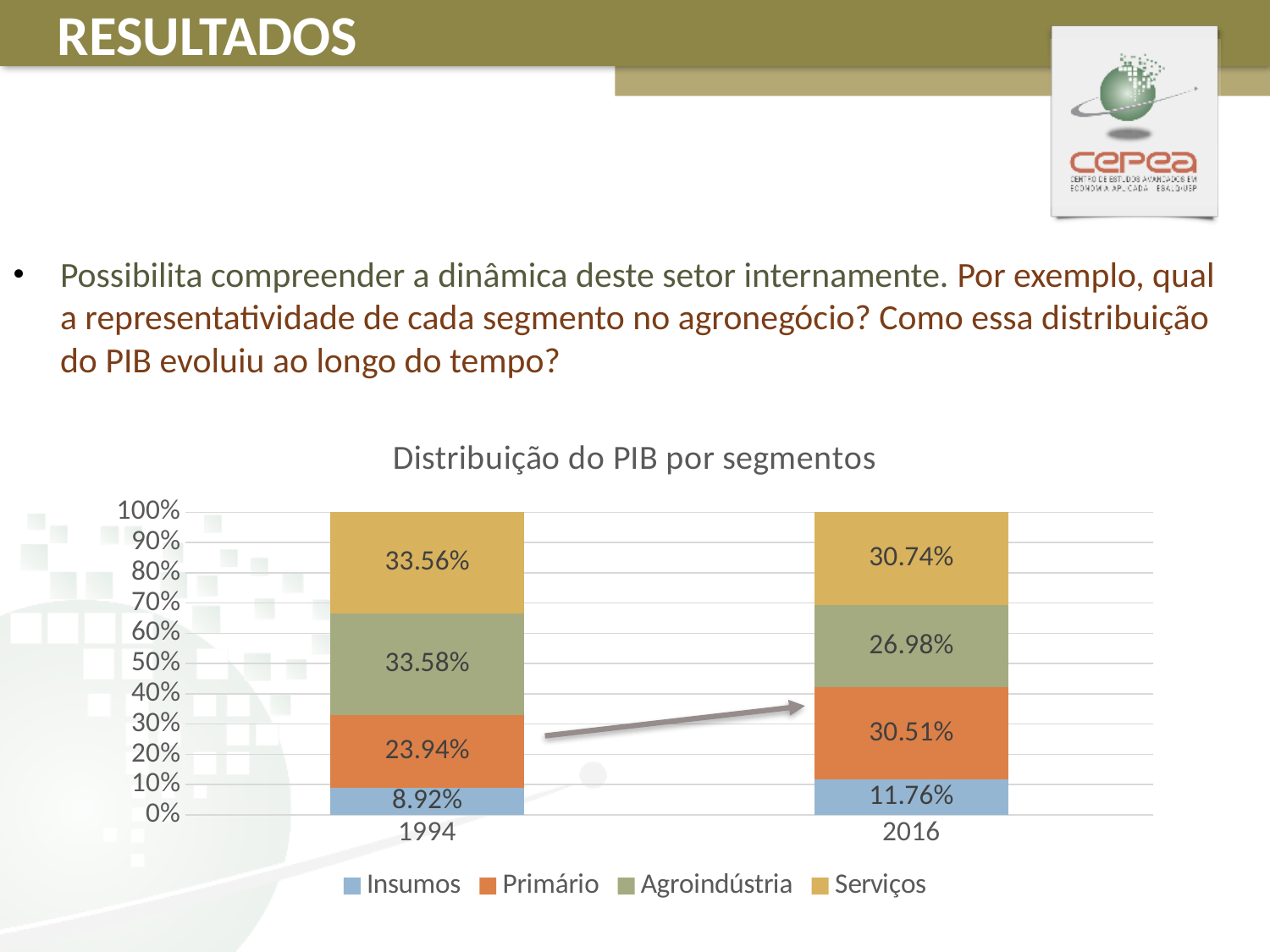
What share does Insumos have in 1994? 8.92% Which segment has the smallest share in 1994? Insumos Does the Insumos share rise or fall from 1994 to 2016? rise By how many percentage points did the Insumos share change from 1994 to 2016? 2.84 percentage points What share does Serviços have in 2016? 30.74% What share does Primário have in 1994? 23.94% Which segment has the smallest share in 2016? Insumos What share does Agroindústria have in 2016? 26.98% By how many percentage points did the Primário share change from 1994 to 2016? 6.57 percentage points What kind of chart is shown? stacked bar chart Which is larger: the Agroindústria share in 1994 or in 2016? 1994 How many series does the legend list? 4